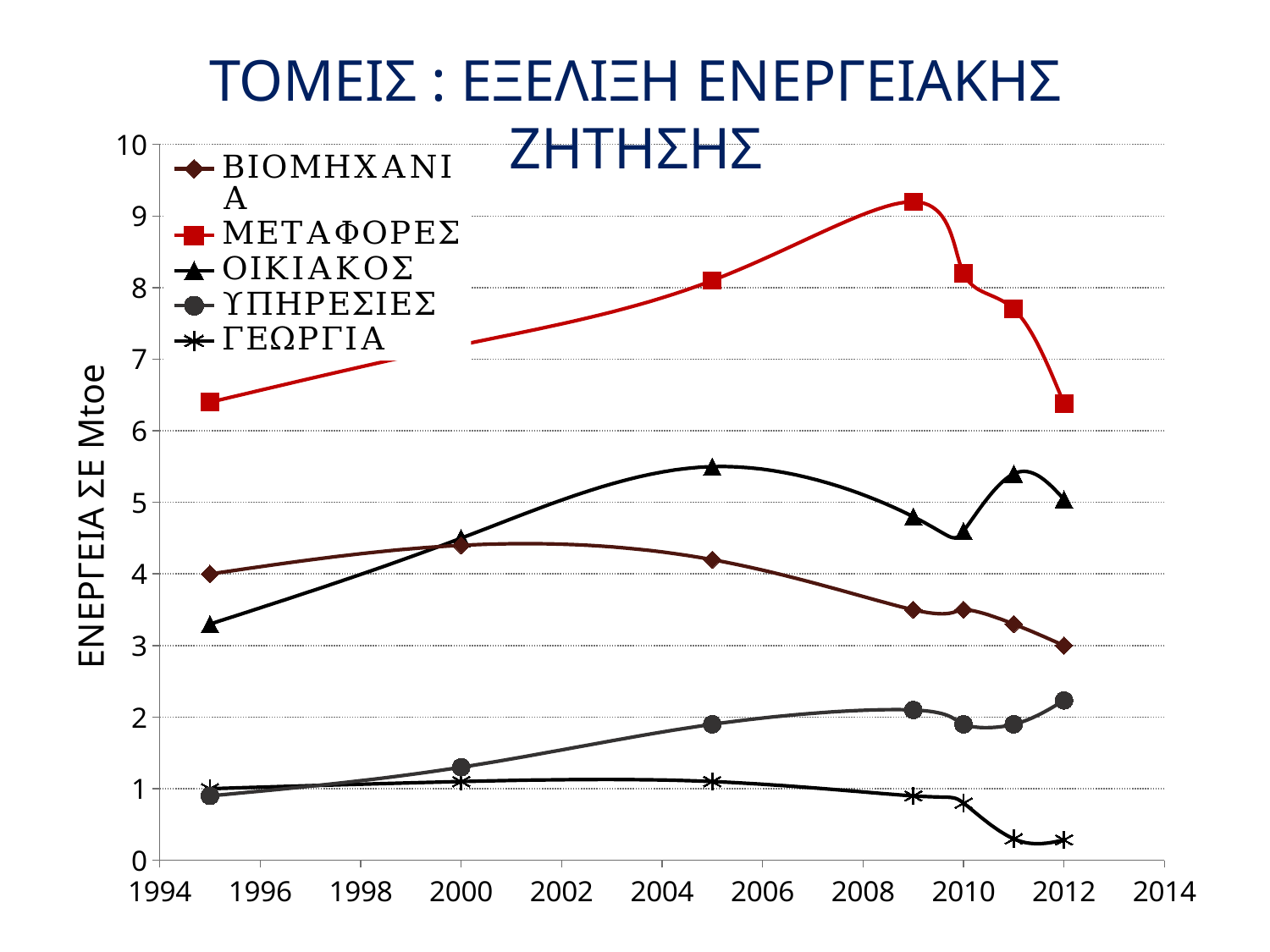
Which series has the highest value in 2012? ΜΕΤΑΦΟΡΕΣ How many series does the legend list? 5 What is the label of the vertical axis? ΕΝΕΡΓΕΙΑ ΣΕ Mtoe What kind of chart is shown on the slide? line chart Is the value for ΜΕΤΑΦΟΡΕΣ in 2009 greater or less than 9? greater Is the value for ΓΕΩΡΓΙΑ in 2012 greater or less than 1? less In which year does the ΜΕΤΑΦΟΡΕΣ series reach its highest value? 2009 In 1995, which is larger: the value for ΒΙΟΜΗΧΑΝΙΑ or the value for ΟΙΚΙΑΚΟΣ? ΒΙΟΜΗΧΑΝΙΑ Does the ΒΙΟΜΗΧΑΝΙΑ series rise or fall from 2005 to 2012? fall Which series has the lowest value in 2012? ΓΕΩΡΓΙΑ Is the value for ΟΙΚΙΑΚΟΣ in 2005 greater or less than 5? greater